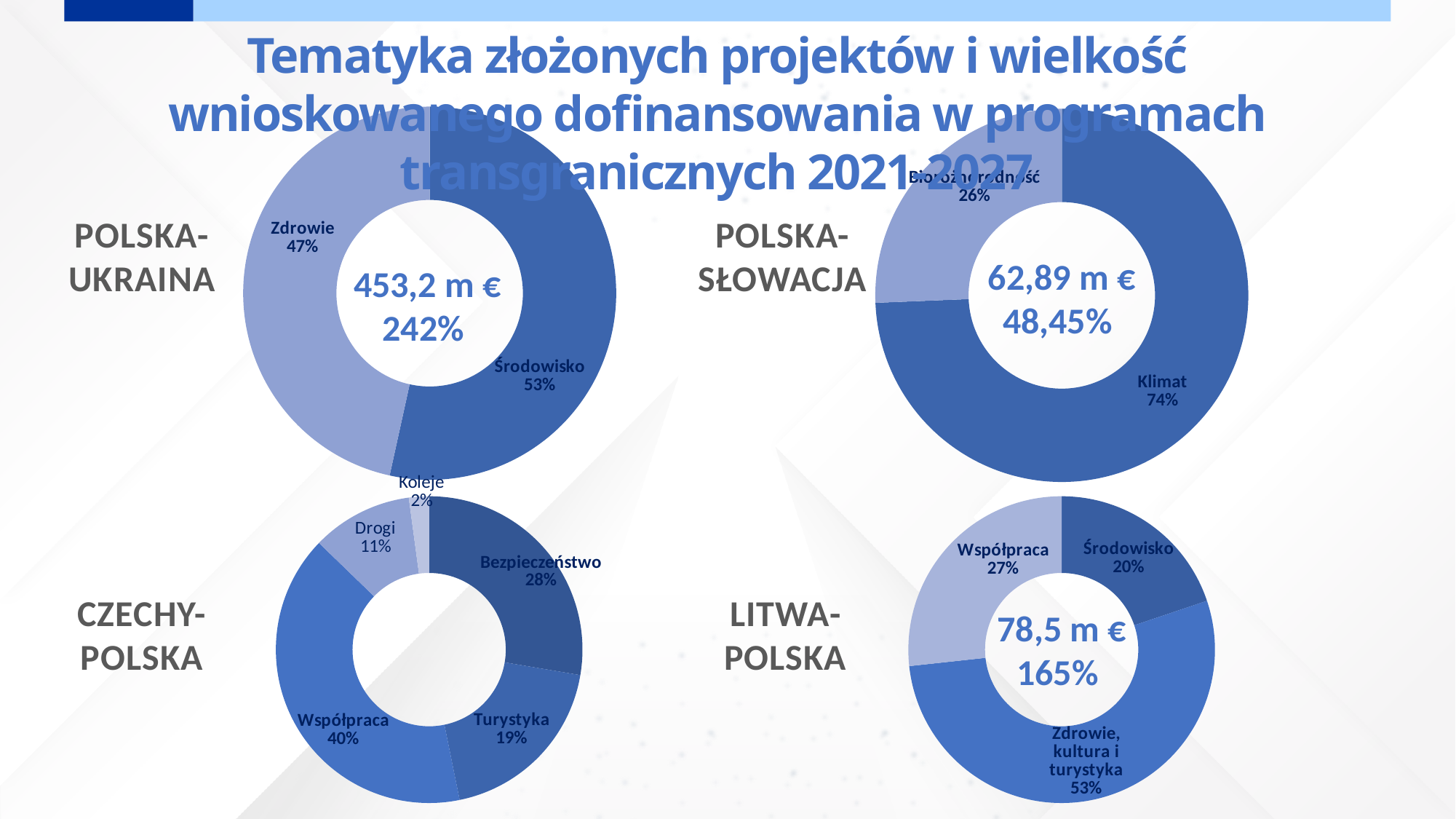
In the POLSKA-SŁOWACJA chart, what share does Klimat have? 74% In the POLSKA-UKRAINA chart, what share does Zdrowie have? 47% In the POLSKA-UKRAINA chart, what share does Środowisko have? 53% In the LITWA-POLSKA chart, which is larger: Współpraca or Środowisko? Współpraca What amount is shown in the centre of the LITWA-POLSKA chart? 78,5 m € In the CZECHY-POLSKA chart, which category has the smallest share? Koleje In the CZECHY-POLSKA chart, which category has the largest share? Współpraca In the CZECHY-POLSKA chart, what is the difference between the shares of Bezpieczeństwo and Turystyka? 9 percentage points What kind of chart is used for the POLSKA-UKRAINA program? Doughnut chart How many categories are shown in the CZECHY-POLSKA chart? 5 In the POLSKA-SŁOWACJA chart, which category has the largest share? Klimat In the LITWA-POLSKA chart, what share does Zdrowie, kultura i turystyka have? 53%